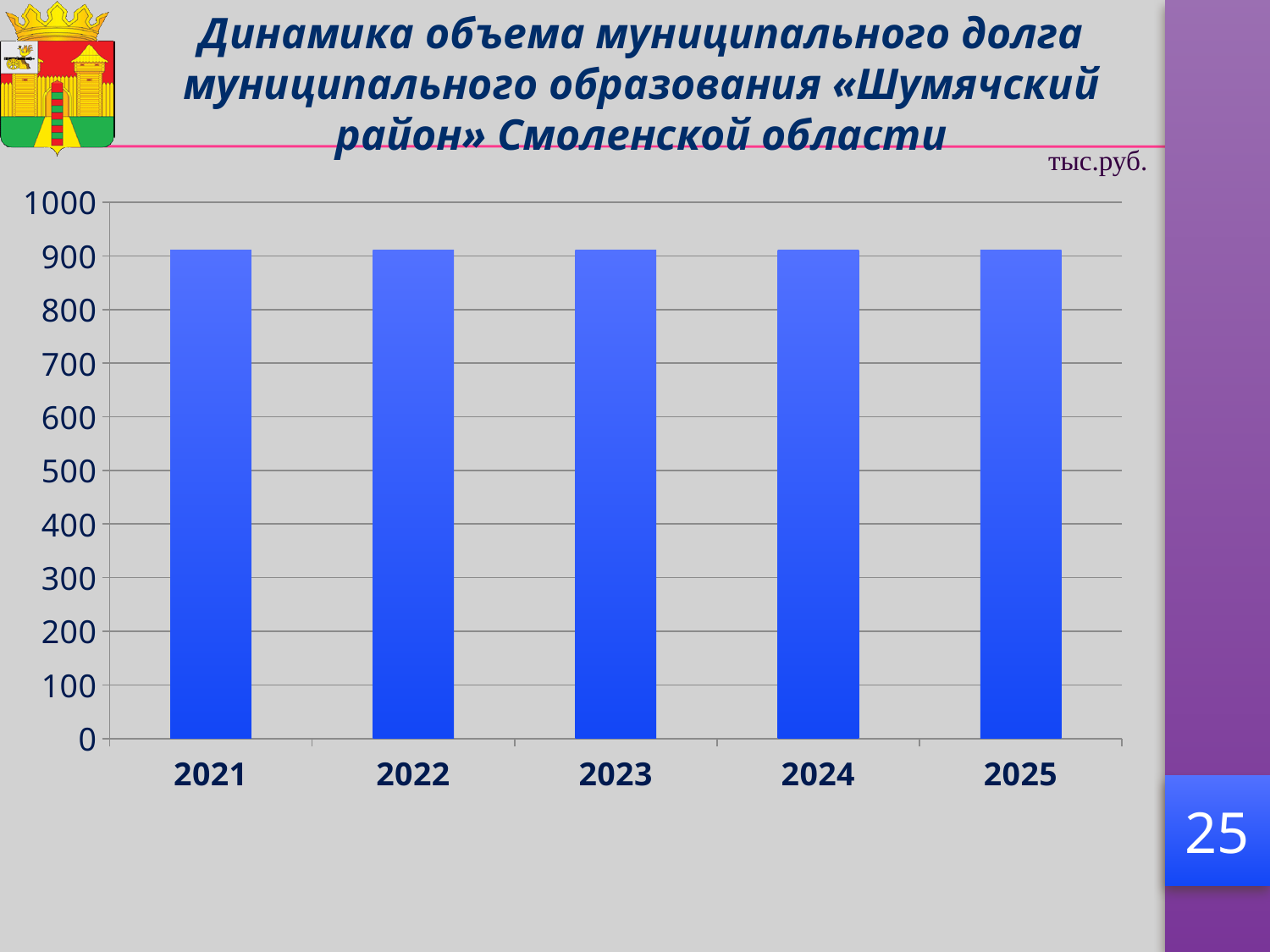
How many years (bars) are shown on the chart? 5 Is the value for 2022 greater or less than 700? greater Is the value for 2025 greater or less than 500? greater Is the value for 2023 greater or less than 1000? less What kind of chart is shown on the slide? bar chart Do the values rise, fall, or stay roughly the same from 2021 to 2025? stay roughly the same What is the first year shown on the x axis? 2021 What unit of measurement is indicated above the chart? тыс.руб.